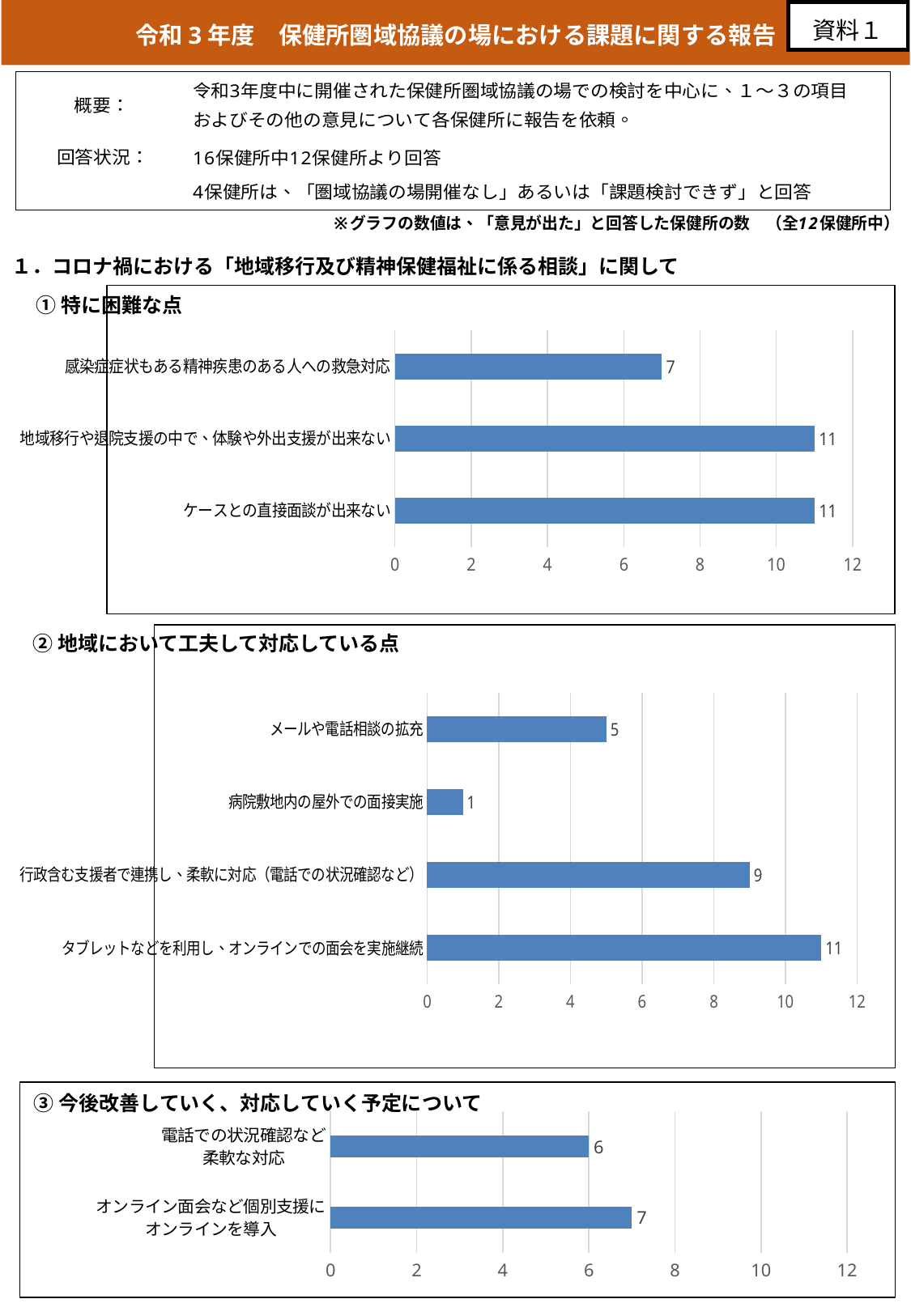
In the chart titled ② 地域において工夫して対応している点, how many categories are plotted? 4 In the chart titled ③ 今後改善していく、対応していく予定について, what is the value for オンライン面会など個別支援にオンラインを導入? 7 In the chart titled ① 特に困難な点, what is the value for 感染症症状もある精神疾患のある人への救急対応? 7 In the chart titled ① 特に困難な点, which category has the lowest value? 感染症症状もある精神疾患のある人への救急対応 In the chart titled ① 特に困難な点, how many categories are plotted? 3 In the chart titled ② 地域において工夫して対応している点, which is larger: メールや電話相談の拡充 or 行政含む支援者で連携し、柔軟に対応（電話での状況確認など）? 行政含む支援者で連携し、柔軟に対応（電話での状況確認など） In the chart titled ① 特に困難な点, what is the difference between the values for ケースとの直接面談が出来ない and 感染症症状もある精神疾患のある人への救急対応? 4 In the chart titled ② 地域において工夫して対応している点, what is the difference between the values for タブレットなどを利用し、オンラインでの面会を実施継続 and メールや電話相談の拡充? 6 In the chart titled ② 地域において工夫して対応している点, what is the value for 病院敷地内の屋外での面接実施? 1 In the chart titled ② 地域において工夫して対応している点, which category has the highest value? タブレットなどを利用し、オンラインでの面会を実施継続 In the chart titled ③ 今後改善していく、対応していく予定について, which category has the lowest value? 電話での状況確認など柔軟な対応 What kind of chart is the chart titled ③ 今後改善していく、対応していく予定について? Bar chart